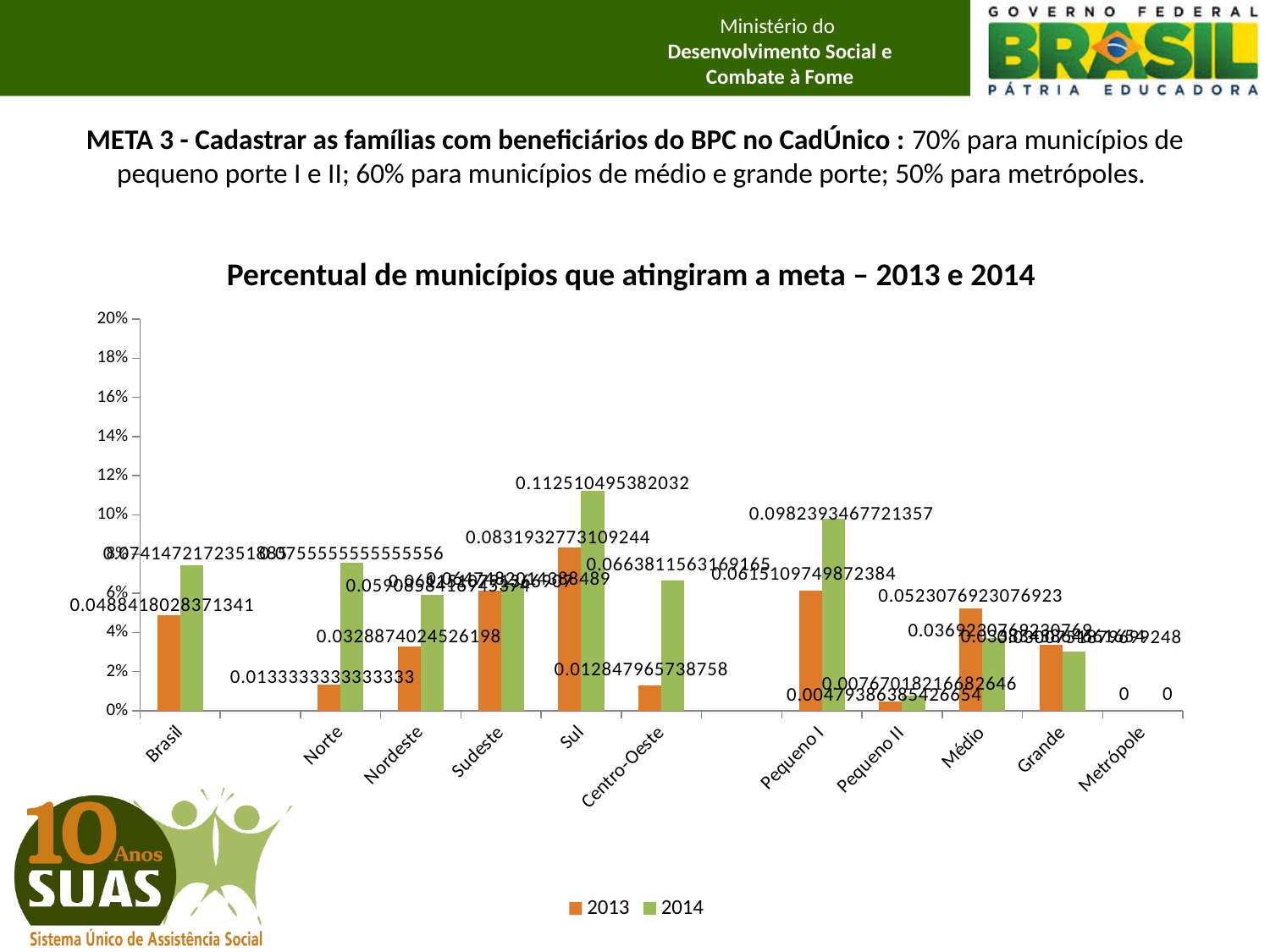
How many series does the legend list? 2 What is the 2014 value for Pequeno I? 0.0982393467721357 For Médio, which year has the larger value, 2013 or 2014? 2013 Is the 2014 value for Sul greater or less than 10%? greater Which category has the highest 2014 value? Sul How many categories are shown on the x axis? 11 What is the 2013 value for Norte? 0.0133333333333333 What is the 2013 value for Brasil? 0.0488418028371341 What is the 2013 value for Centro-Oeste? 0.012847965738758 Which category has the lowest values for both 2013 and 2014? Metrópole What type of chart is shown on the slide? bar chart What is the 2014 value for Sul? 0.112510495382032